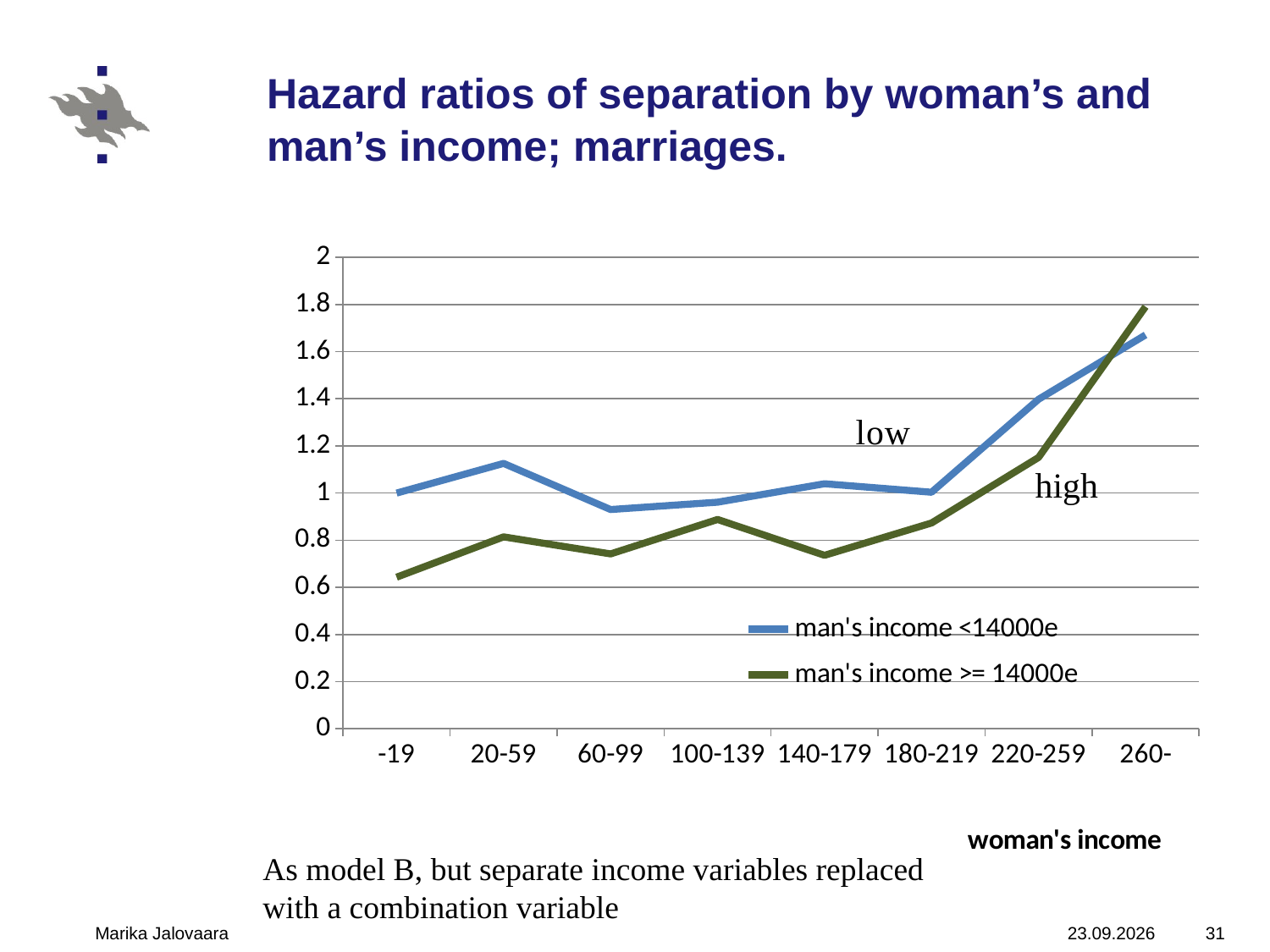
Is the value for man's income >= 14000e at woman's income -19 greater or less than 0.8? less Is the value for man's income <14000e at woman's income 220-259 greater or less than 1.2? greater What is the label of the x axis? woman's income Is the value for man's income <14000e at woman's income 20-59 greater or less than 1? greater At woman's income 220-259, which series has the higher hazard ratio? man's income <14000e How many series does the legend list? 2 What is the hazard ratio for man's income <14000e at woman's income -19? 1 What kind of chart is shown on the slide? line chart How many woman's income categories are shown on the x axis? 8 For the man's income >= 14000e series, which woman's income category has the highest hazard ratio? 260- For the man's income >= 14000e series, which woman's income category has the lowest hazard ratio? -19